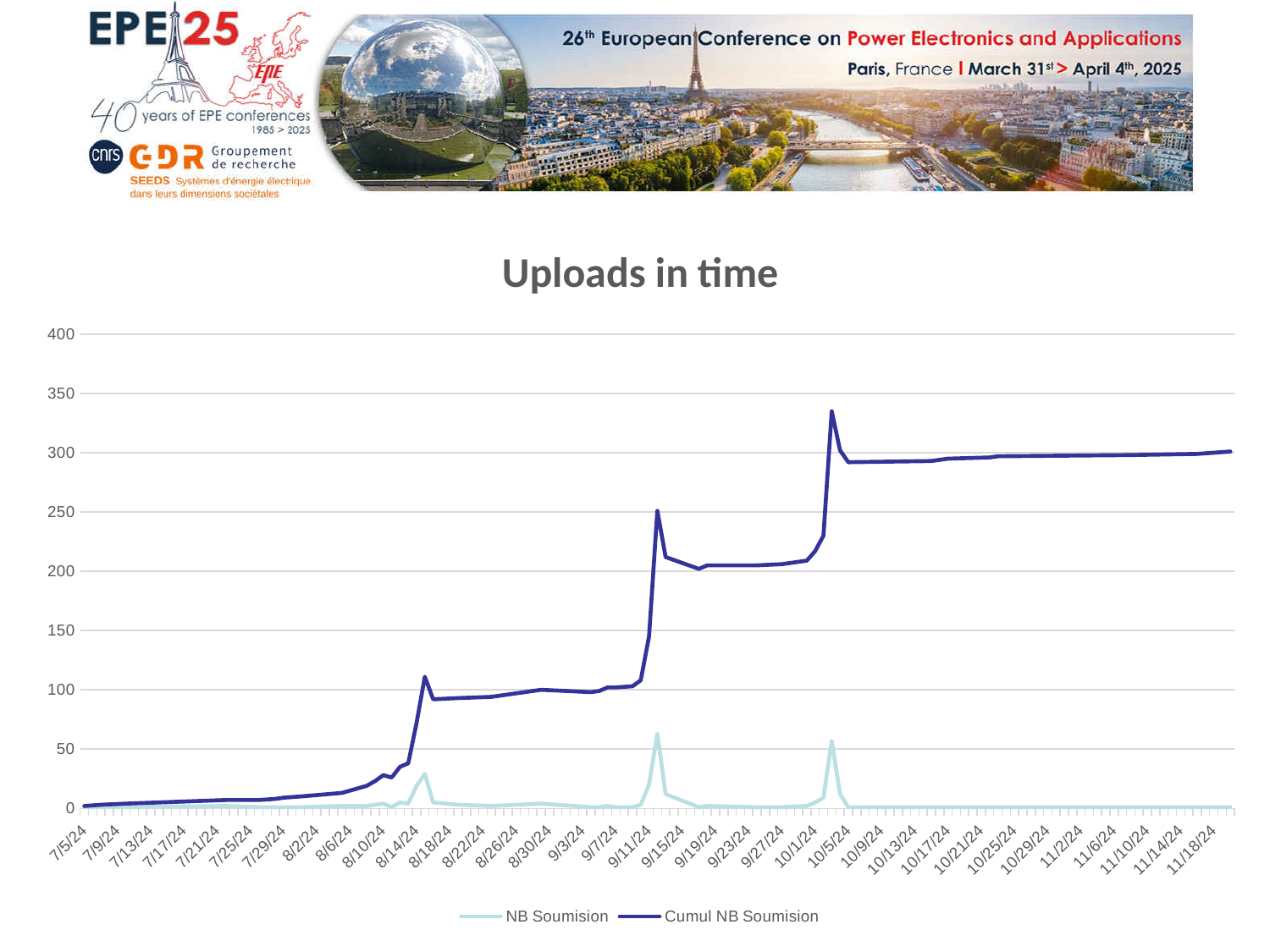
Is the peak of NB Soumision near 9/13/24 greater or less than 100? less Is the value of Cumul NB Soumision at 11/18/24 greater or less than 250? greater How many series does the legend list? 2 What is the highest value shown on the y axis? 400 What is the title of the chart? Uploads in time What are the two series named in the legend? NB Soumision and Cumul NB Soumision Is the value of Cumul NB Soumision at 7/5/24 greater or less than 50? less Does the Cumul NB Soumision series generally rise or fall from 7/5/24 to 11/18/24? rise At 11/18/24, which series has the higher value, NB Soumision or Cumul NB Soumision? Cumul NB Soumision What kind of chart is shown on the slide? line chart